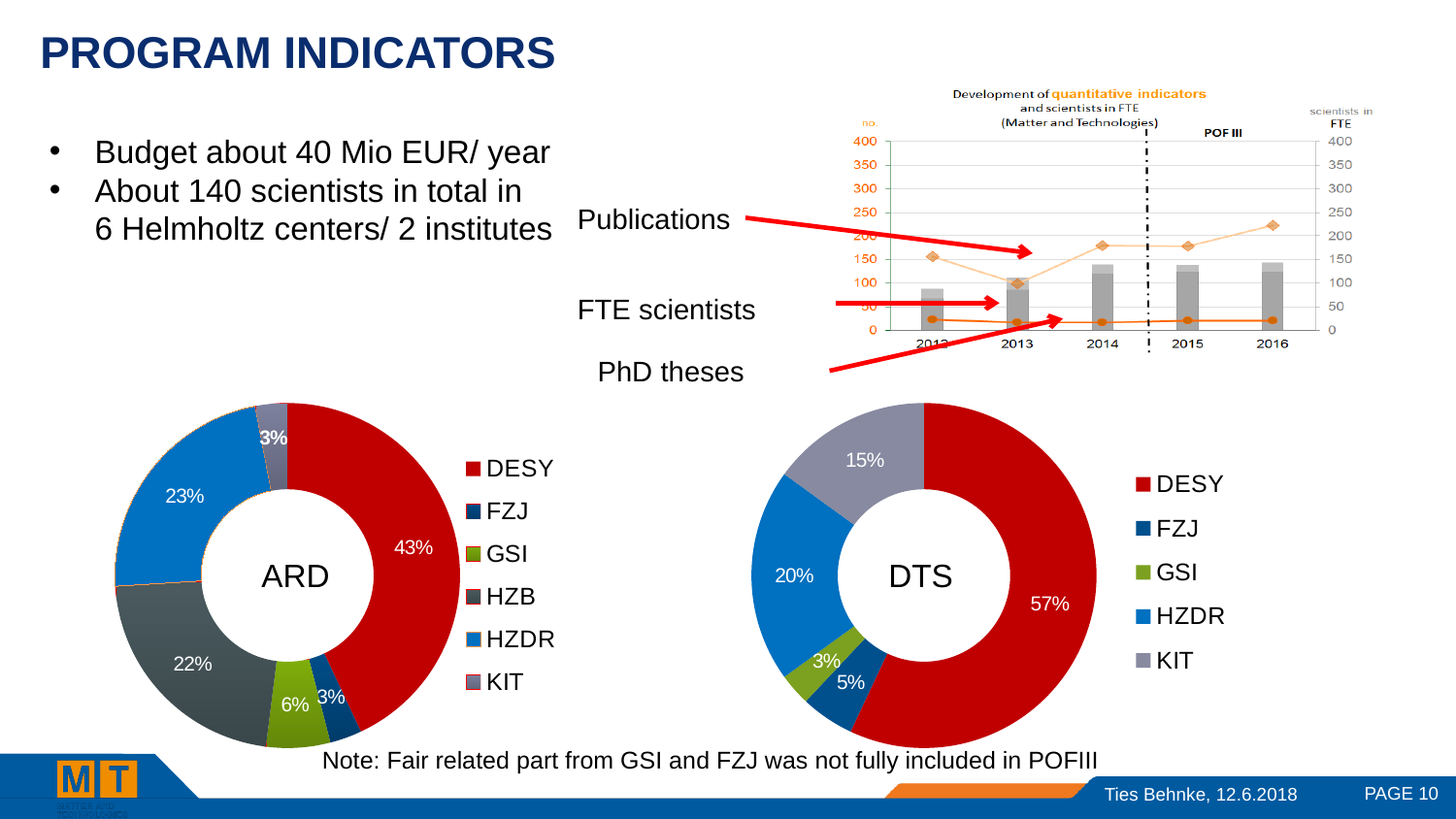
In the DTS donut chart, which center has the largest share? DESY In the 'Development of quantitative indicators' chart, do the Publications values rise or fall from 2013 to 2016? rise In the 'Development of quantitative indicators' chart, is the Publications value for 2013 greater or less than 150? less In the ARD donut chart, which center has the smallest share, GSI or HZB? GSI In the DTS donut chart, what is the difference between the DESY share and the KIT share? 42% In the ARD donut chart, what is the difference between the HZDR share and the HZB share? 1% In the DTS donut chart, what share does HZDR have? 20% In the ARD donut chart, what share does DESY have? 43% In the 'Development of quantitative indicators' chart, is the Publications value for 2016 greater or less than 200? greater How many entries does the legend of the ARD donut chart list? 6 How many entries does the legend of the DTS donut chart list? 5 What kind of chart is the ARD chart? Donut (pie) chart